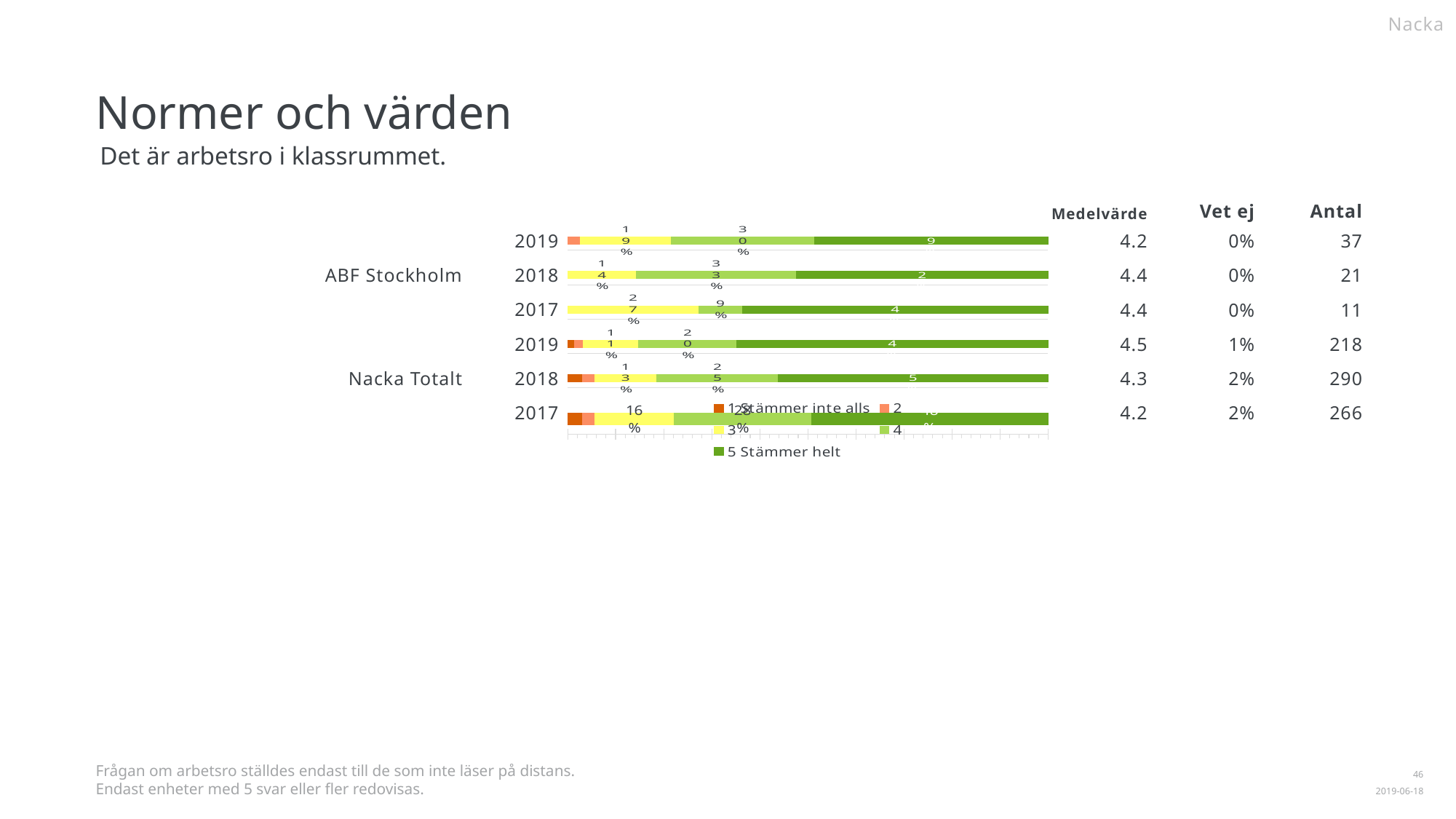
What is the Antal for Nacka Totalt in 2018? 290 What is the first entry in the chart legend? 1 Stämmer inte alls How many bars are plotted in the chart? 6 What is the Medelvärde for ABF Stockholm in 2019? 4.2 What is the difference in Antal between Nacka Totalt 2019 and ABF Stockholm 2019? 181 What kind of chart is shown on the slide? bar chart What is the Vet ej value for Nacka Totalt in 2017? 2% Which row has the lowest Antal? ABF Stockholm 2017 Which row has the highest Medelvärde? Nacka Totalt 2019 Which has the higher Medelvärde in 2018, ABF Stockholm or Nacka Totalt? ABF Stockholm How many series does the chart legend list? 5 Does the Medelvärde for Nacka Totalt rise or fall from 2017 to 2019? rise